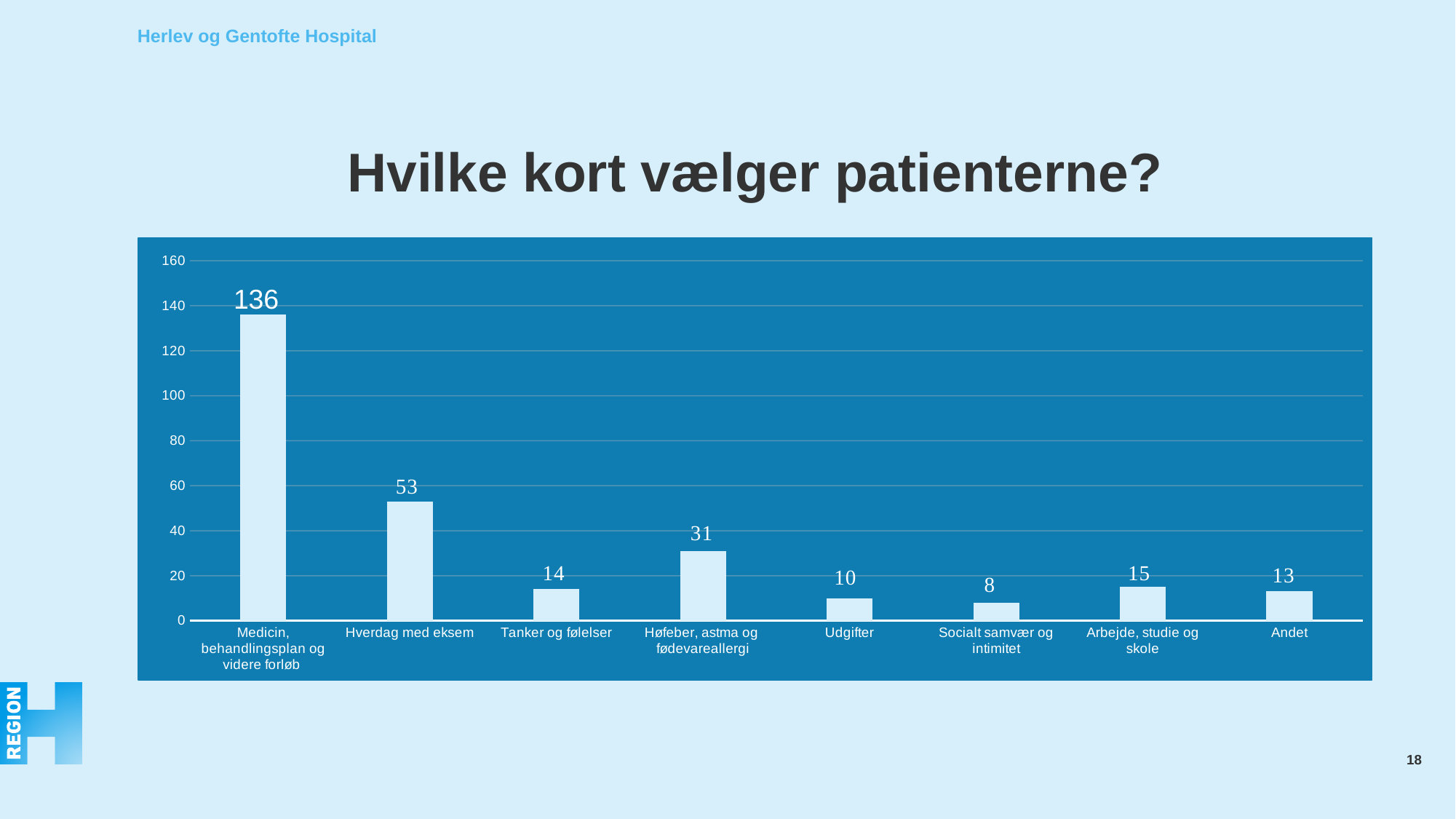
What is the value for "Medicin, behandlingsplan og videre forløb"? 136 Is the value for "Hverdag med eksem" greater or less than 60? less What is the title of the slide above the chart? Hvilke kort vælger patienterne? Which category has the highest value? Medicin, behandlingsplan og videre forløb What is the value for "Høfeber, astma og fødevareallergi"? 31 What is the value for "Andet"? 13 Which category has the lowest value? Socialt samvær og intimitet What is the difference between the values for "Medicin, behandlingsplan og videre forløb" and "Hverdag med eksem"? 83 How many categories are shown on the x axis? 8 Which is larger, the value for "Tanker og følelser" or the value for "Arbejde, studie og skole"? Arbejde, studie og skole What kind of chart is shown on the slide? bar chart What is the value for "Hverdag med eksem"? 53